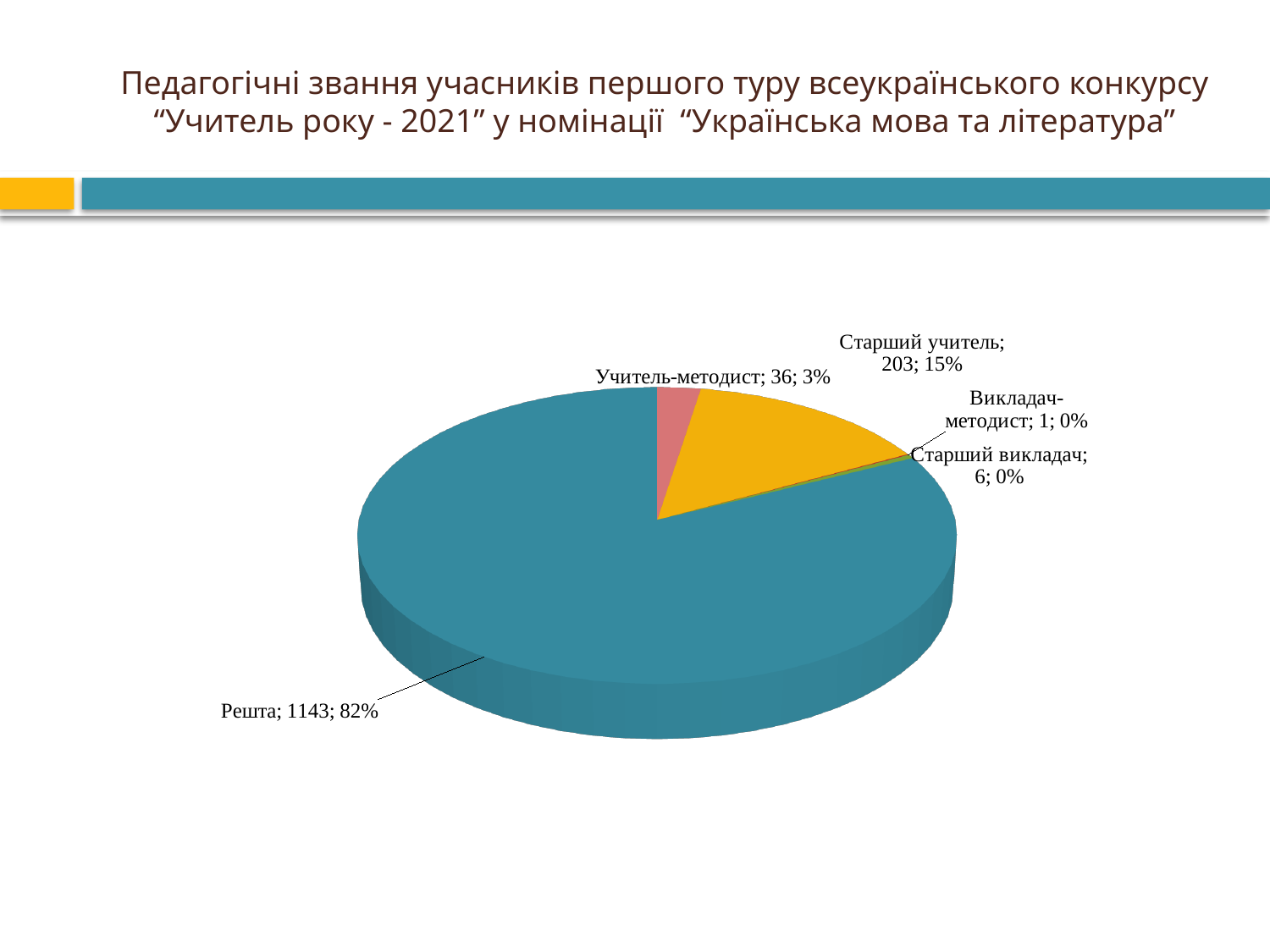
What is the value for Решта? 1143 What is the value for Старший викладач? 6 Which category has the smallest slice? Викладач-методист Which category has the largest slice? Решта Which is larger, the value for Старший викладач or the value for Викладач-методист? Старший викладач What is the value for Учитель-методист? 36 What share of the pie does Старший учитель represent? 15% What kind of chart is shown on the slide? pie chart How many slices does the pie chart have? 5 What share of the pie does Решта represent? 82% What is the difference between the values for Старший учитель and Учитель-методист? 167 What is the value for Старший учитель? 203